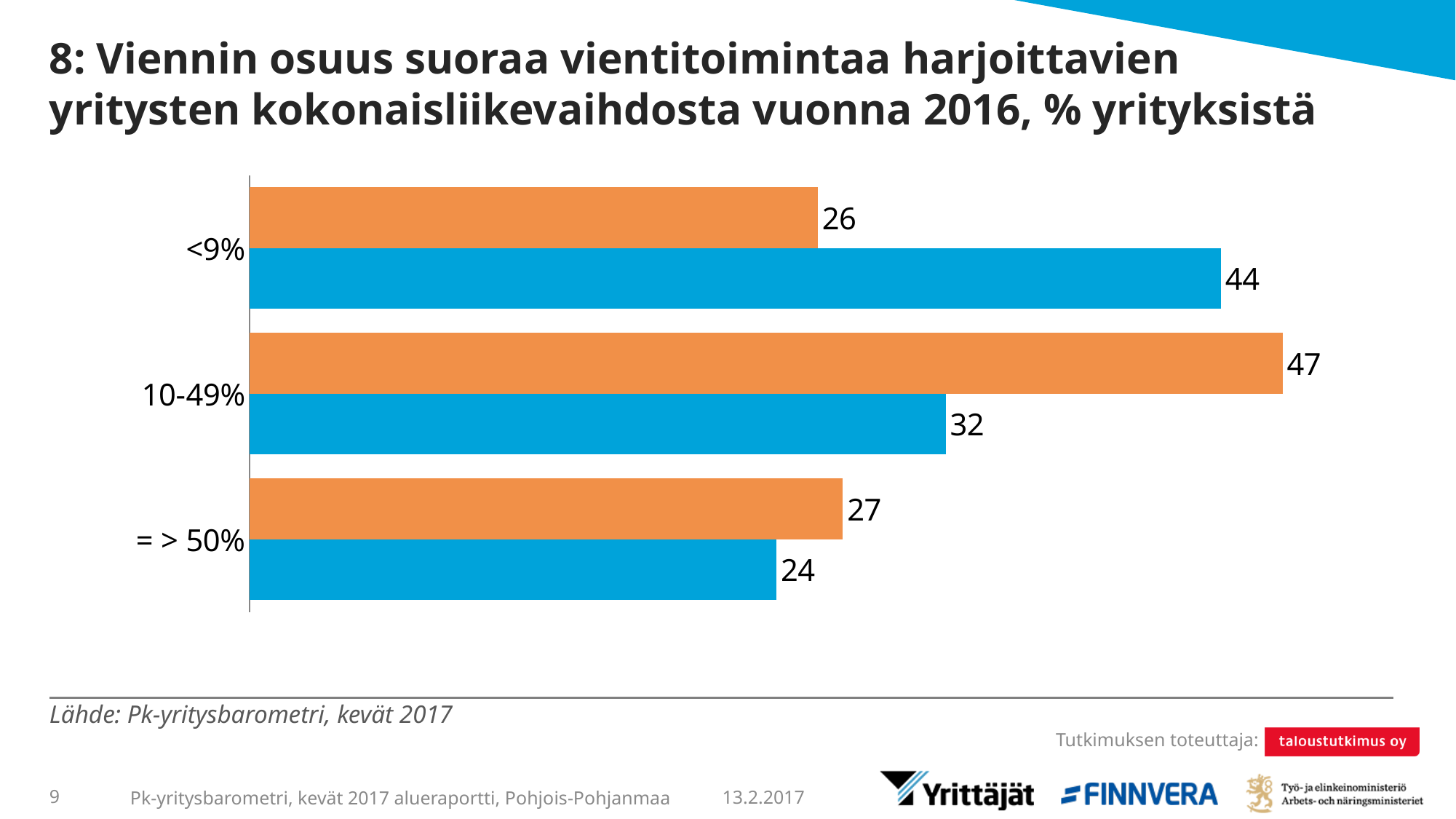
For the = > 50% category, which bar is larger, orange or blue? orange How many categories are shown on the chart? 3 What is the difference between the blue and orange bars for the <9% category? 18 What type of chart is shown on the slide? bar chart Which category has the highest orange bar? 10-49% Which category has the lowest blue bar? = > 50% What is the difference between the orange and blue bars for the 10-49% category? 15 What is the value of the blue bar for the <9% category? 44 What is the value of the blue bar for the = > 50% category? 24 What is the value of the orange bar for the <9% category? 26 What source is cited below the chart? Pk-yritysbarometri, kevät 2017 What is the value of the orange bar for the 10-49% category? 47